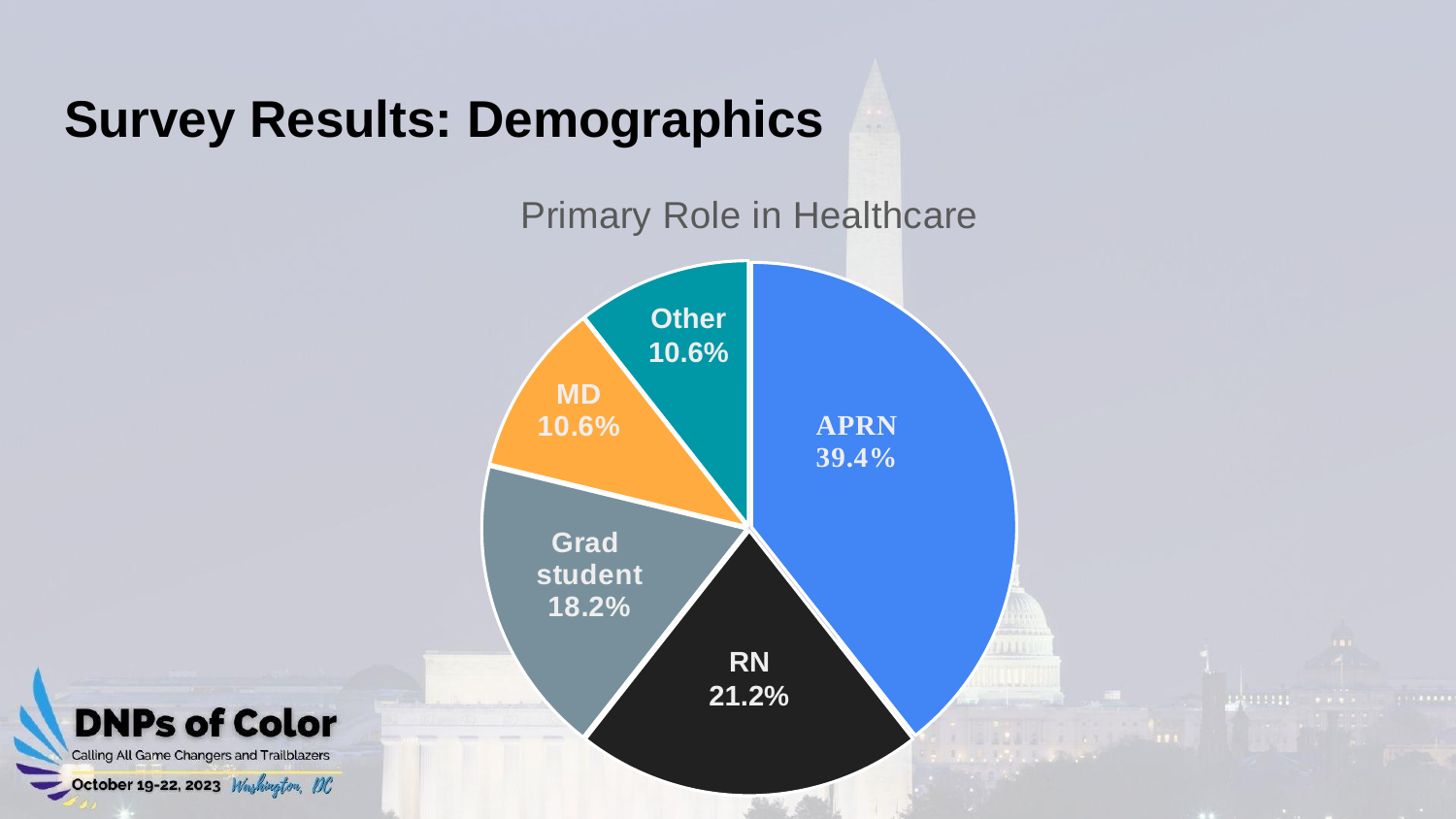
Which category has the largest slice of the pie? APRN What is the title of the chart? Primary Role in Healthcare What percentage of respondents are APRNs? 39.4% What percentage is shown for MD? 10.6% What share of the pie is labelled RN? 21.2% What colour is the APRN slice? Blue What percentage is shown for Grad student? 18.2% How many slices does the pie chart have? 5 What type of chart is shown on the slide? Pie chart What is the difference in percentage points between APRN and RN? 18.2 Which is larger, the RN slice or the Grad student slice? RN Which categories share the smallest slice of the pie? MD and Other